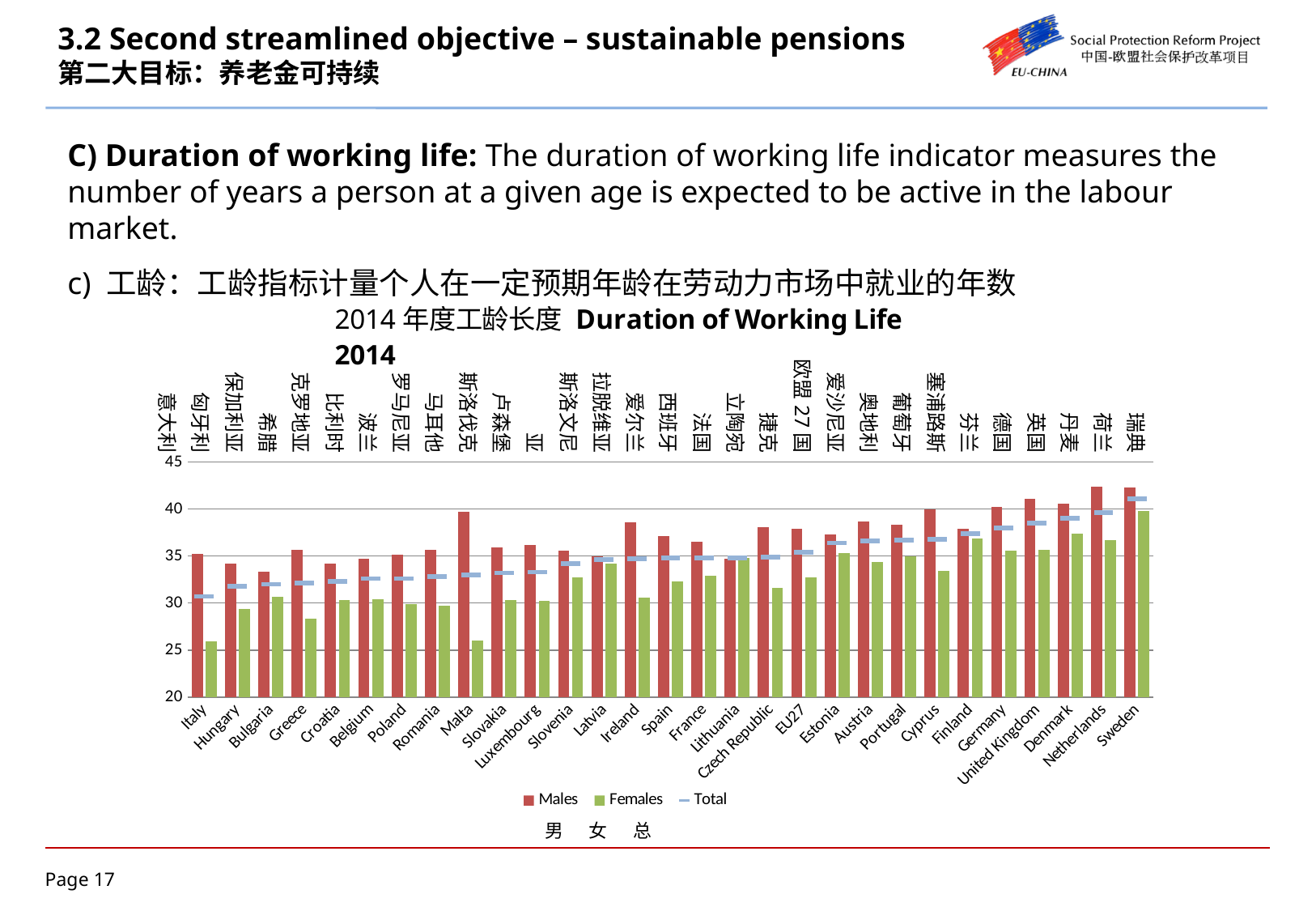
Which category has the lowest Total value? Italy How many countries/categories are shown on the x axis? 29 What kind of chart is shown on the slide? bar chart Is the Females value for Greece greater or less than 30? less Is the Females value for Italy greater or less than 25? greater Do the Total values generally rise or fall moving from Italy on the left to Sweden on the right? rise How many series does the legend list? 3 Is the Males value for Netherlands greater or less than 40? greater Which category has the highest Total value? Sweden Which category has the highest Females value? Sweden What are the three legend entries of the chart? Males, Females, Total Which is larger, the Males value for Malta or the Males value for Slovakia? Malta